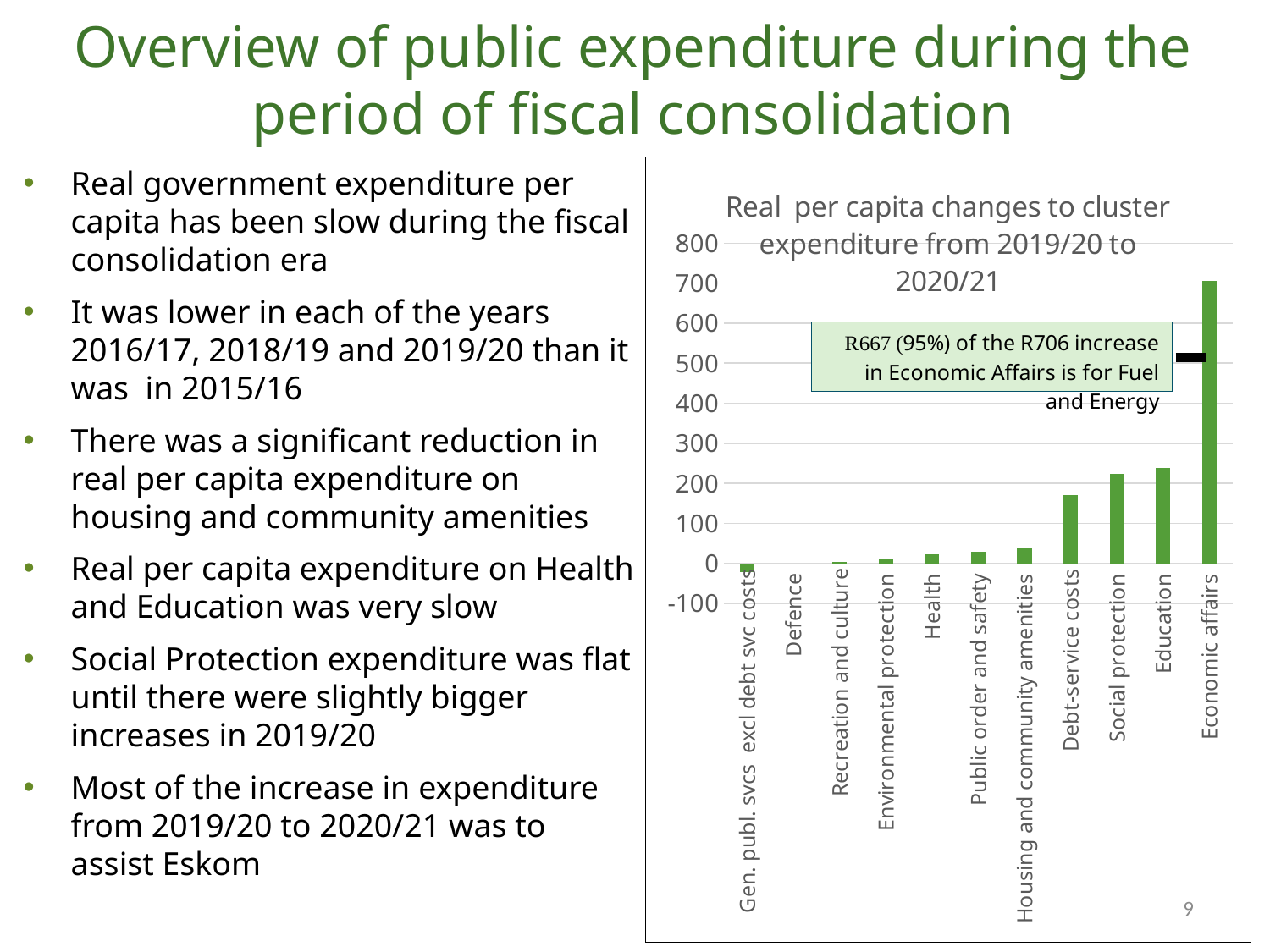
What type of chart is shown on the slide? Bar chart What is the title of the chart? Real per capita changes to cluster expenditure from 2019/20 to 2020/21 Is the value for Health greater or less than 100? less According to the annotation, how much of the Economic affairs increase is for Fuel and Energy? R667 (95%) Which category has the lowest value on the chart? Gen. publ. svcs excl debt svc costs Is the value for Debt-service costs greater or less than 100? greater Do the bar values generally rise or fall from left to right along the x axis? rise According to the annotation on the chart, what is the increase in Economic affairs? R706 How many categories are plotted on the chart? 11 Is the value for Economic affairs greater or less than 600? greater Which is larger, the value for Debt-service costs or the value for Social protection? Social protection Which category has the highest value on the chart? Economic affairs